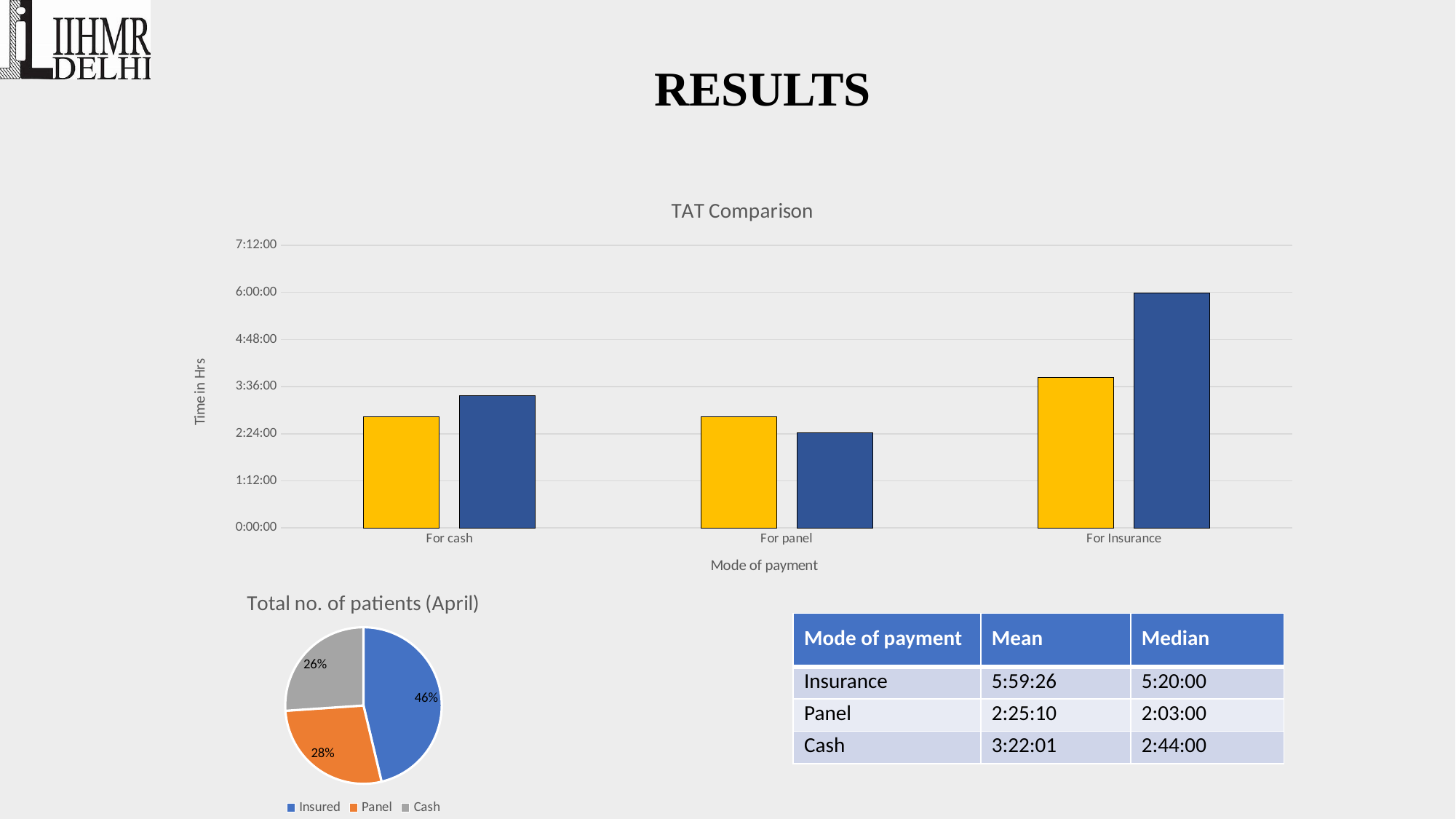
In the TAT Comparison chart, what kind of chart is shown? bar chart In the TAT Comparison chart, is the yellow bar for For cash greater or less than 3:36:00? less In the Total no. of patients (April) chart, what share of patients is Insured? 46% In the Total no. of patients (April) chart, what is the difference in percentage points between the Insured and Panel slices? 18 In the TAT Comparison chart, what is the title of the vertical axis? Time in Hrs In the TAT Comparison chart, is the blue bar for For Insurance greater or less than 4:48:00? greater In the TAT Comparison chart, for For cash, which bar is taller, the yellow bar or the blue bar? the blue bar In the TAT Comparison chart, for For panel, which bar is taller, the yellow bar or the blue bar? the yellow bar In the Total no. of patients (April) chart, which category has the smallest slice? Cash In the TAT Comparison chart, how many modes of payment are shown on the x axis? 3 In the TAT Comparison chart, which mode of payment has the tallest blue bar? For Insurance In the Total no. of patients (April) chart, how many categories does the legend list? 3